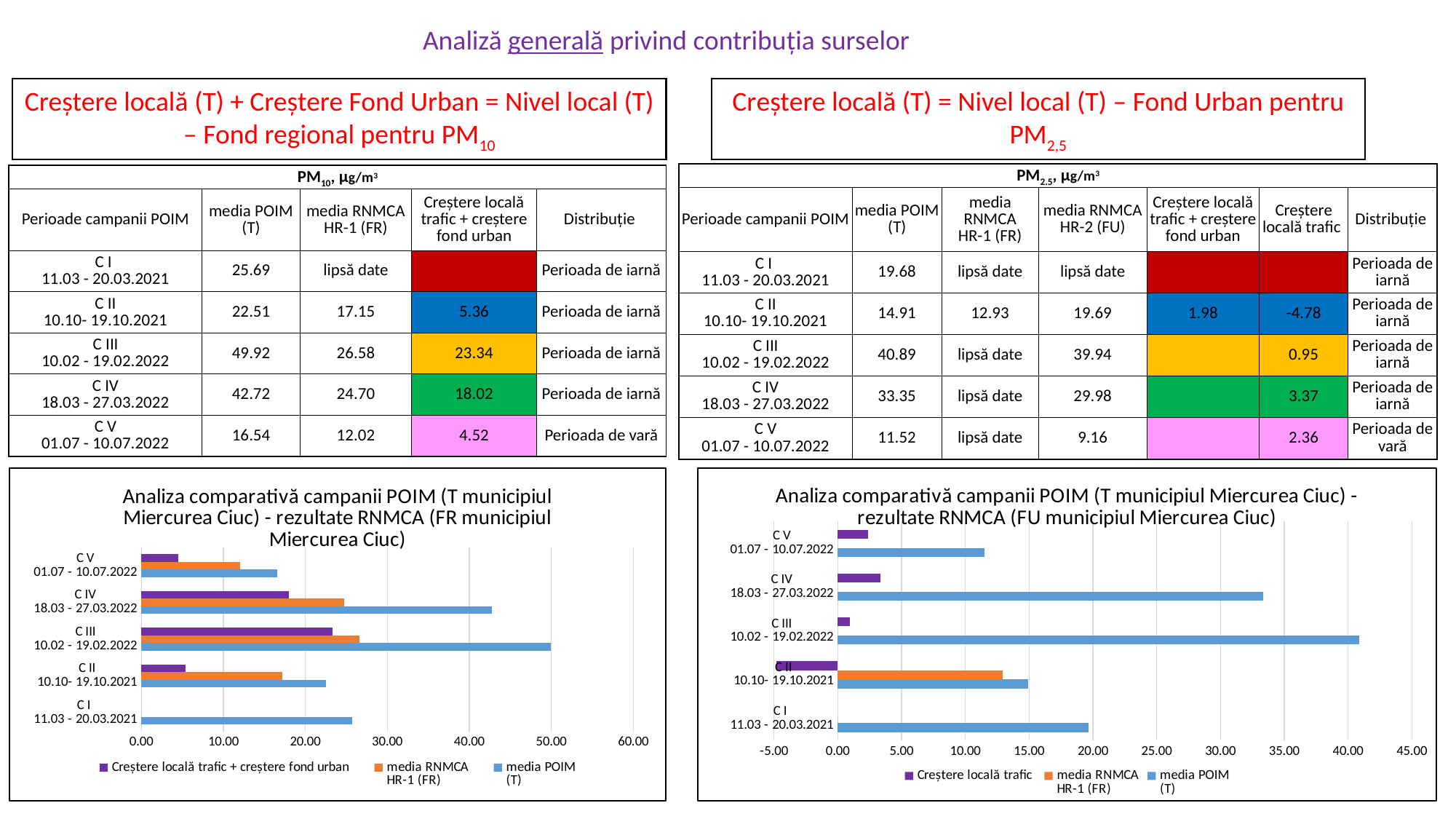
In the right chart (rezultate RNMCA FU), which campaign has the highest media POIM (T) value? C III In the left chart (rezultate RNMCA FR), how many campaign periods are shown on the vertical axis? 5 In the right chart (rezultate RNMCA FU), is the Creștere locală trafic value for C II greater or less than 0.00? less In the left chart (rezultate RNMCA FR), which campaign has the highest media POIM (T) value? C III In the left chart (rezultate RNMCA FR), how many series does the legend list? 3 In the left chart (rezultate RNMCA FR), is the media POIM (T) value for C V greater or less than 20.00? less In the right chart (rezultate RNMCA FU), what colour are the media POIM (T) bars? blue In the right chart (rezultate RNMCA FU), how many series does the legend list? 3 In the left chart (rezultate RNMCA FR), is the media POIM (T) value for C III greater or less than 40.00? greater In the left chart (rezultate RNMCA FR), which is larger: the media POIM (T) value for C IV or for C II? C IV In the left chart (rezultate RNMCA FR), which campaign has the lowest media POIM (T) value? C V What kind of chart is the left chart titled 'Analiza comparativă campanii POIM (T municipiul Miercurea Ciuc) - rezultate RNMCA (FR municipiul Miercurea Ciuc)'? bar chart